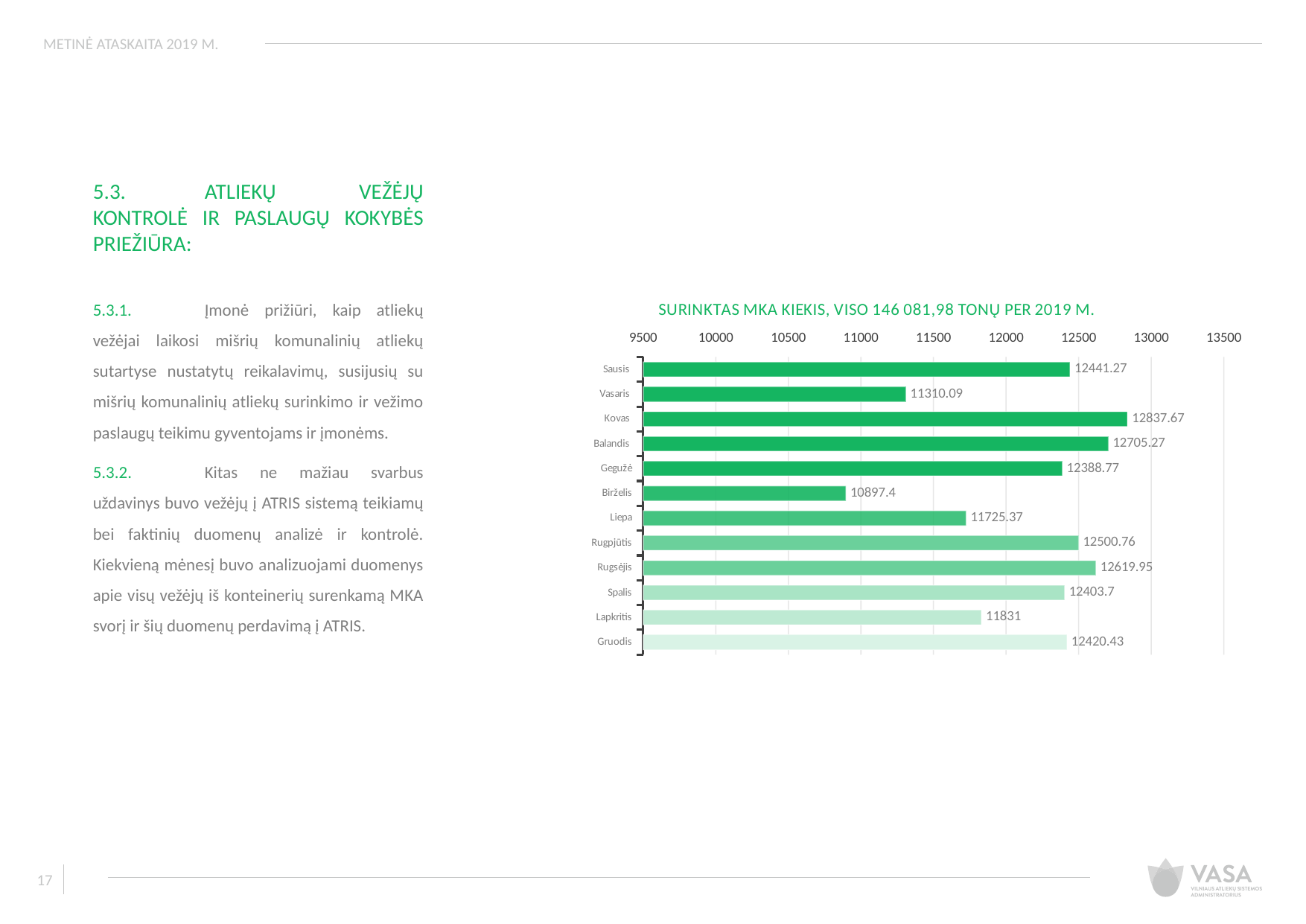
What is the difference between the values for Sausis and Vasaris? 1131.18 What is the value for Birželis? 10897.4 What is the title of the chart? SURINKTAS MKA KIEKIS, VISO 146 081,98 TONŲ PER 2019 M. Which month has the lowest value? Birželis What is the value for Lapkritis? 11831 Which is larger, the value for Rugsėjis or the value for Rugpjūtis? Rugsėjis How many months are shown in the chart? 12 Is the value for Lapkritis greater or less than 12000? less What is the difference between the values for Kovas and Birželis? 1940.27 What is the value for Kovas? 12837.67 Which month has the highest value? Kovas What kind of chart is shown on the slide? bar chart